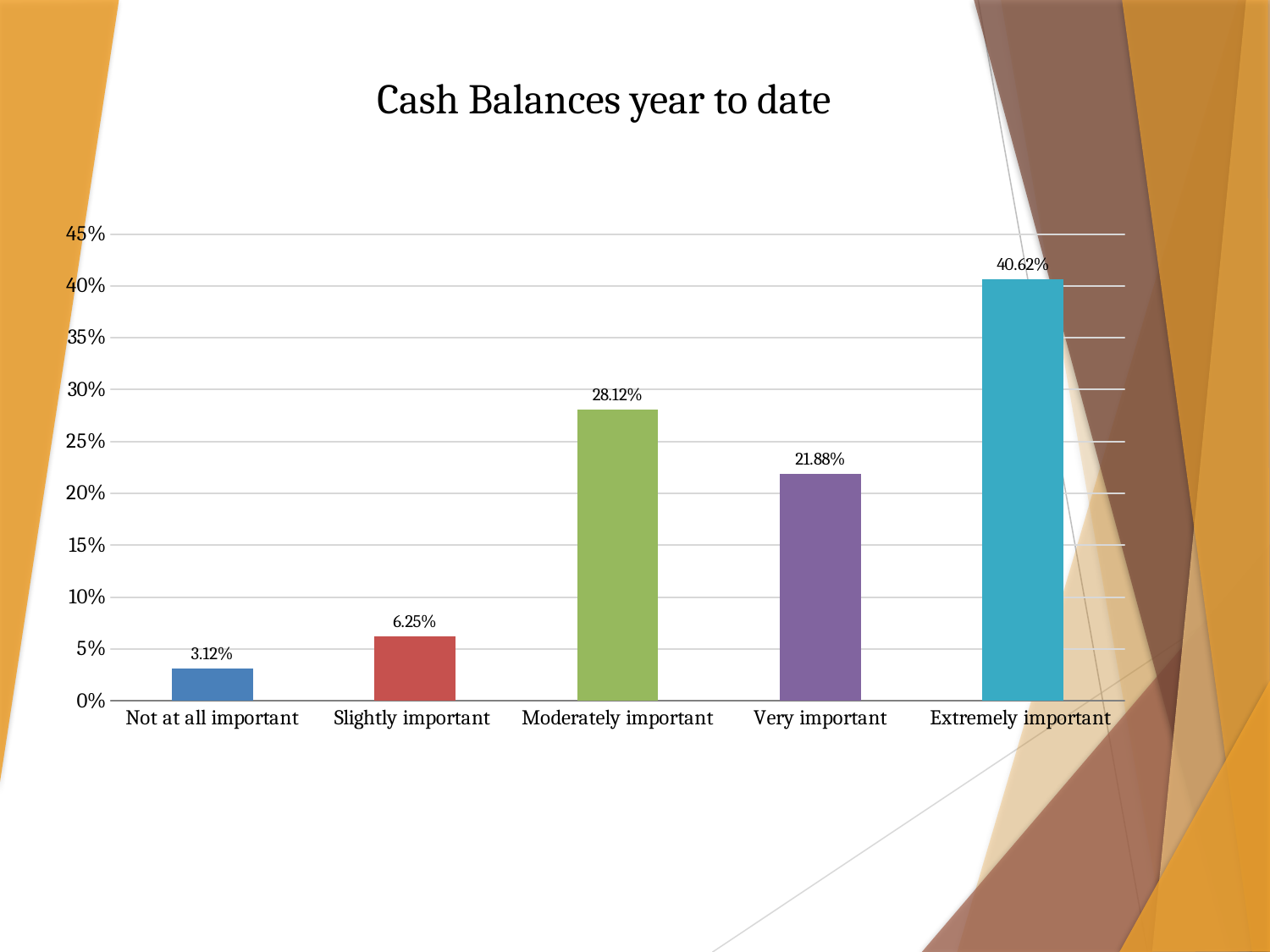
Which category has the highest value? Extremely important What is the difference between the values for Extremely important and Moderately important? 12.5% What is the value for Moderately important? 28.12% Is the value for Slightly important greater or less than 10%? less What kind of chart is shown on the slide? bar chart What is the value for Not at all important? 3.12% Which category has the lowest value? Not at all important Which is larger, the value for Moderately important or the value for Very important? Moderately important What is the title of the chart? Cash Balances year to date What is the value for Extremely important? 40.62% What is the value for Very important? 21.88% How many categories are shown on the x axis? 5